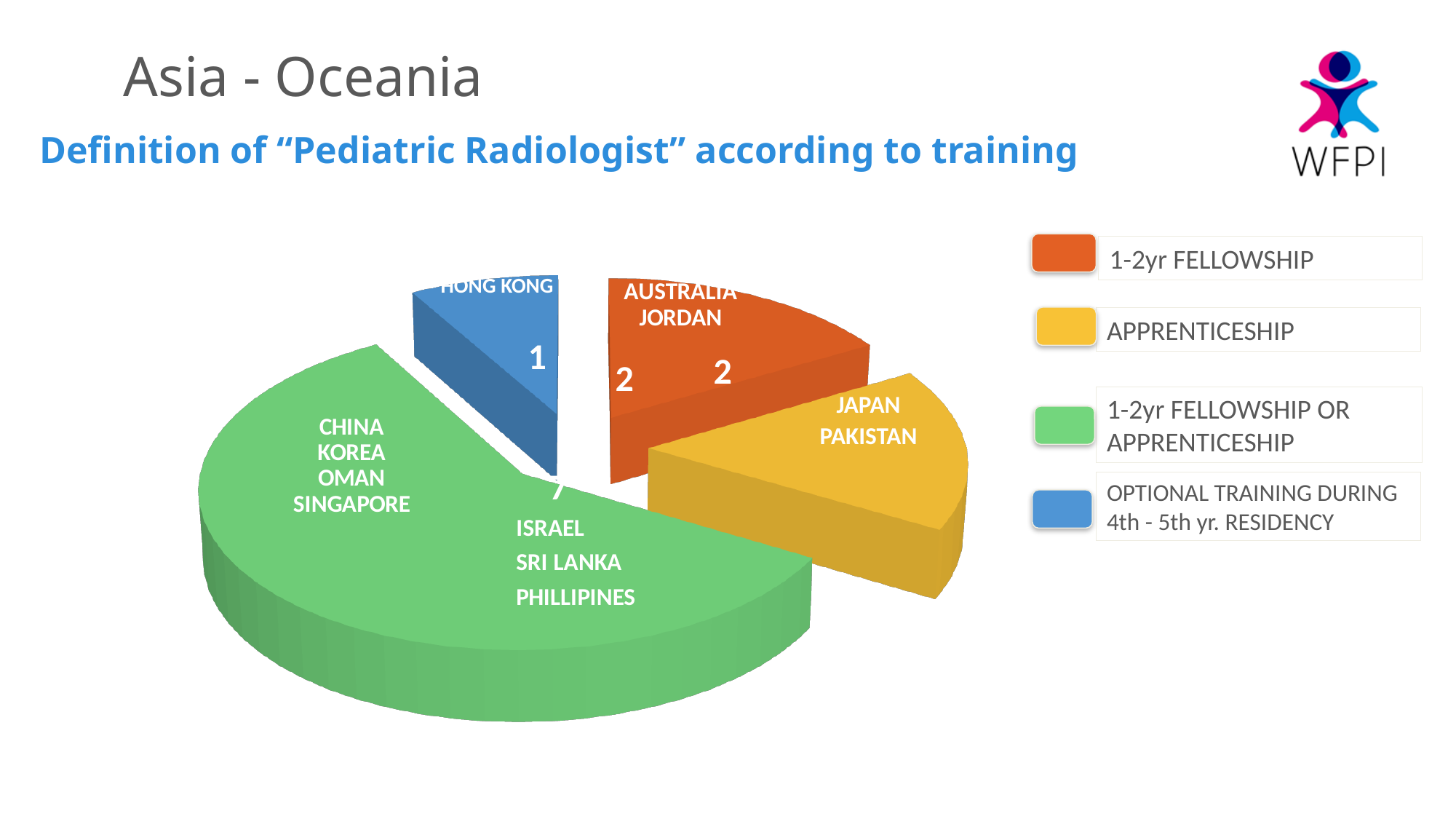
How many slices does the pie chart have? 4 Which is larger: the value for the HONG KONG slice or the value for the AUSTRALIA/JORDAN slice? AUSTRALIA/JORDAN Which training category has the smallest slice of the pie? OPTIONAL TRAINING DURING 4th - 5th yr. RESIDENCY How many entries does the legend list? 4 Which countries are listed in the JAPAN slice of the pie? JAPAN, PAKISTAN Which colour represents APPRENTICESHIP in the legend? yellow Which training category has the largest slice of the pie? 1-2yr FELLOWSHIP OR APPRENTICESHIP What kind of chart is shown on the slide? pie chart What value is shown for the slice labelled AUSTRALIA and JORDAN? 2 What value is shown for the slice containing CHINA, KOREA, OMAN and SINGAPORE? 7 What is the difference between the value of the largest slice (7) and the HONG KONG slice (1)? 6 What value is shown for the slice labelled HONG KONG? 1